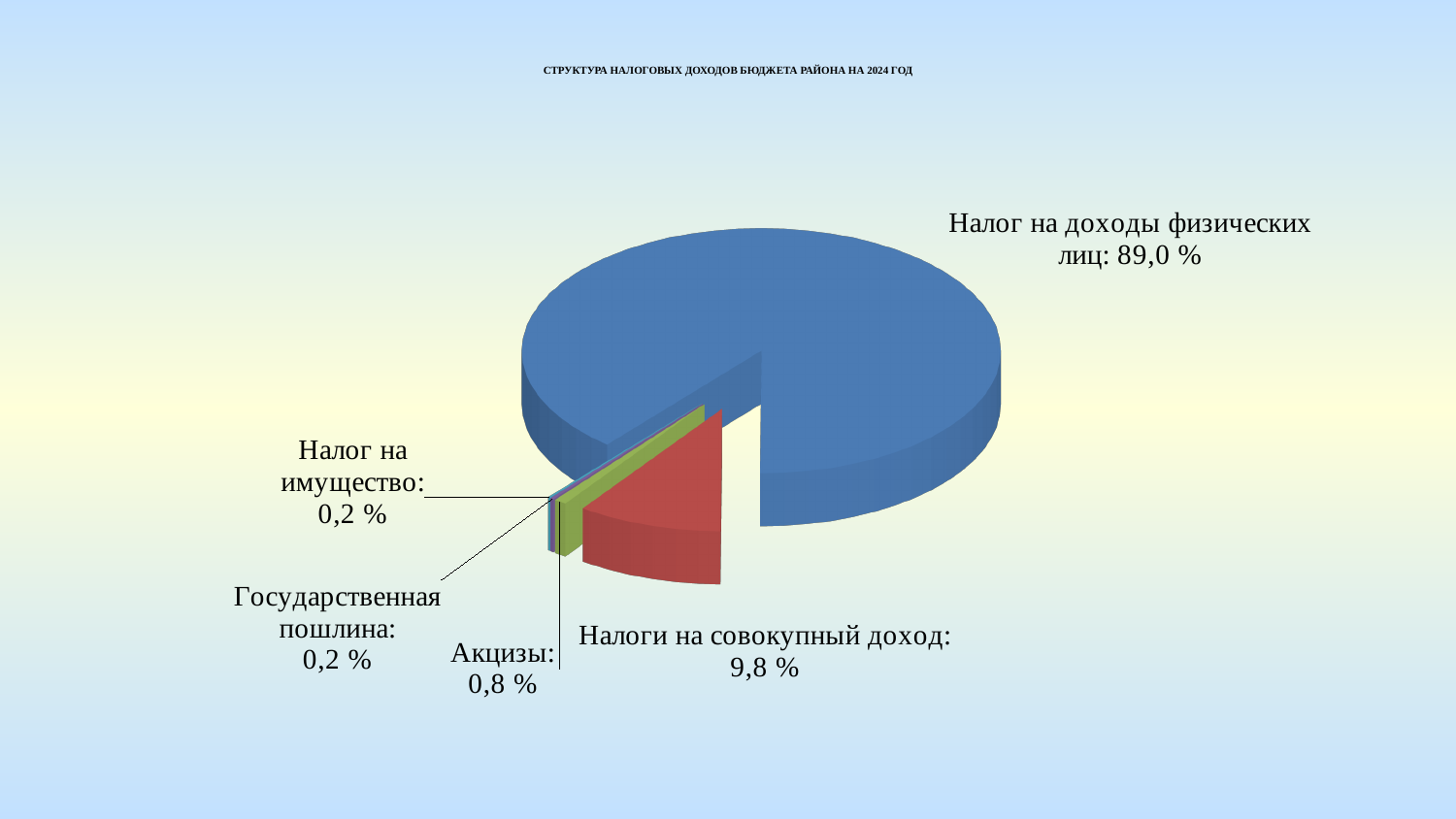
What is the title of the chart on the slide? СТРУКТУРА НАЛОГОВЫХ ДОХОДОВ БЮДЖЕТА РАЙОНА НА 2024 ГОД What is the value shown for "Государственная пошлина"? 0,2 % What is the value shown for "Акцизы"? 0,8 % What is the value shown for "Налоги на совокупный доход"? 9,8 % What is the difference between the shares of "Налог на доходы физических лиц" and "Налоги на совокупный доход"? 79,2 % What share of the pie does "Налог на доходы физических лиц" have? 89,0 % What kind of chart is shown on the slide? Pie chart What is the value shown for "Налог на имущество"? 0,2 % Which is larger: the share of "Акцизы" or the share of "Налог на имущество"? Акцизы Which category has the largest slice of the pie? Налог на доходы физических лиц What colour is the slice for "Налоги на совокупный доход"? Red How many slices (categories) does the pie chart have? 5